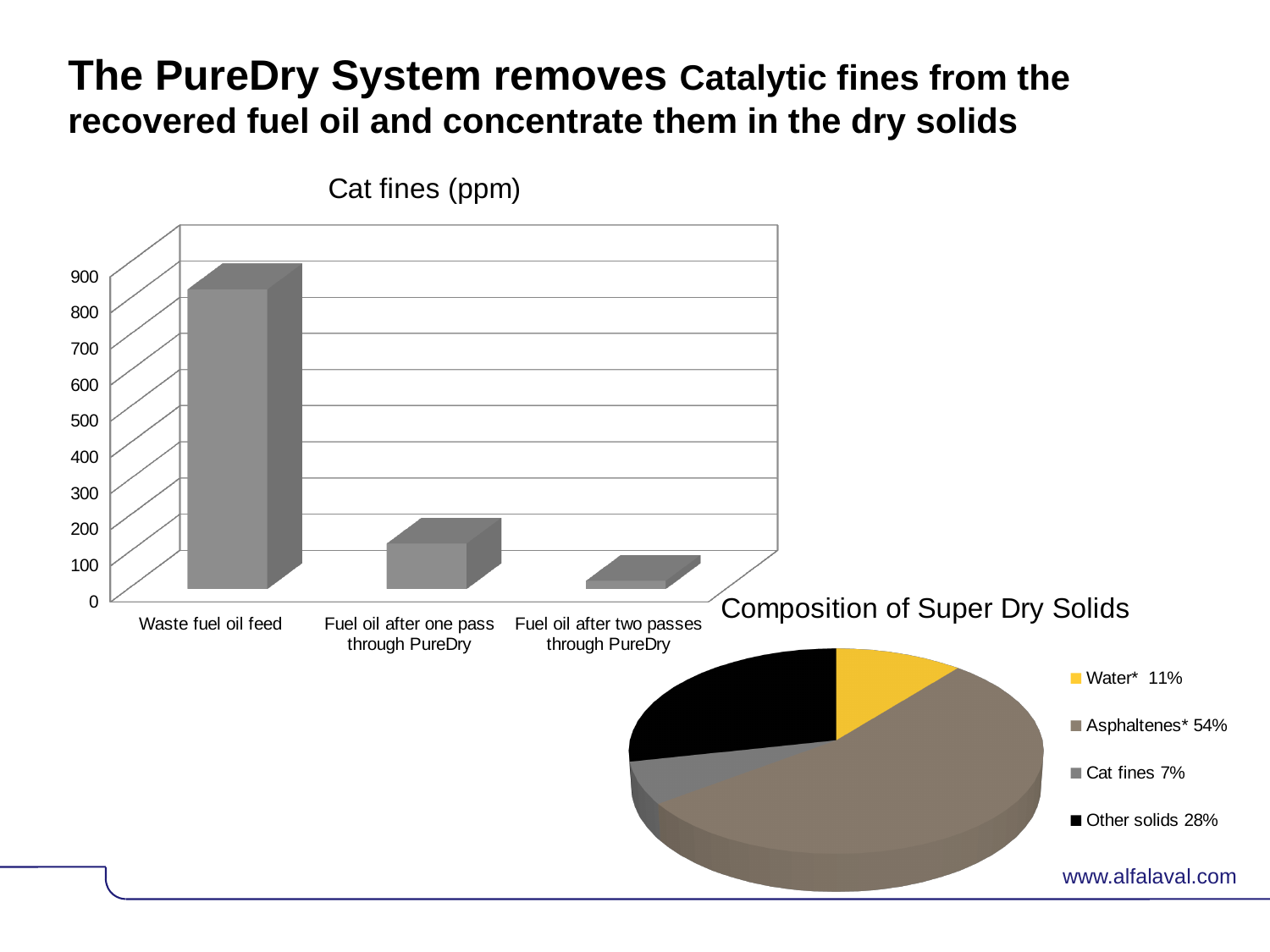
In the Composition of Super Dry Solids chart, what is the difference between the Other solids share and the Water* share? 17% In the Composition of Super Dry Solids chart, what share is Cat fines? 7% In the Cat fines (ppm) chart, is the value for Fuel oil after one pass through PureDry greater or less than 300? less In the Cat fines (ppm) chart, how many categories are shown? 3 In the Cat fines (ppm) chart, do the values rise or fall from left to right? fall In the Cat fines (ppm) chart, is the value for Waste fuel oil feed greater or less than 500? greater In the Cat fines (ppm) chart, which category has the lowest value? Fuel oil after two passes through PureDry In the Composition of Super Dry Solids chart, which component has the smallest share? Cat fines What kind of chart is the Cat fines (ppm) chart? bar chart In the Composition of Super Dry Solids chart, what share is Asphaltenes*? 54% In the Composition of Super Dry Solids chart, how many slices does the legend list? 4 In the Cat fines (ppm) chart, which category has the highest value? Waste fuel oil feed